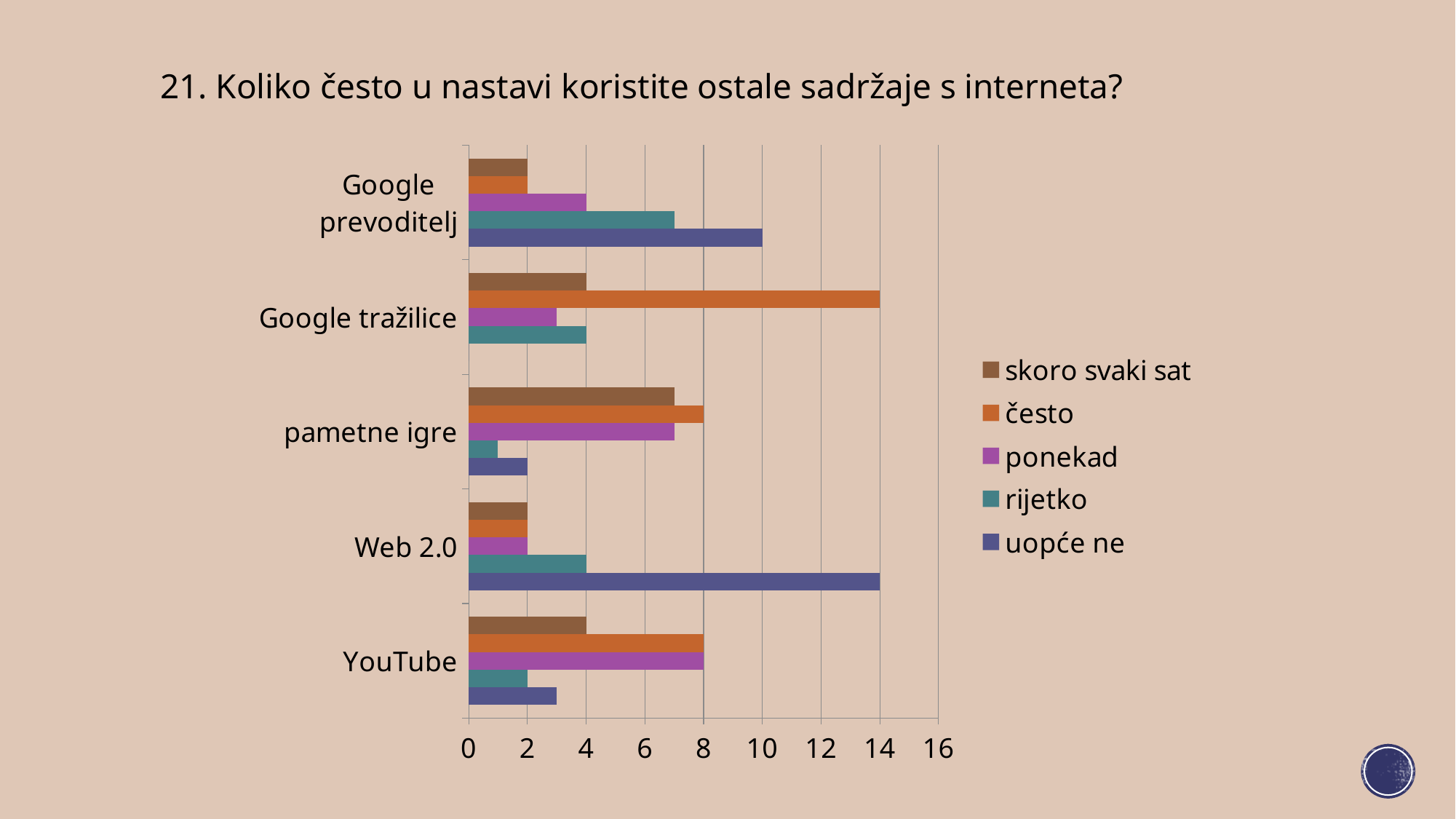
How many categories are shown on the chart? 5 What is the value for "uopće ne" for Google prevoditelj? 10 What is the value for "uopće ne" for Web 2.0? 14 How many series does the legend list? 5 Is the value for "rijetko" for Google prevoditelj greater or less than 6? greater Which is larger for pametne igre: "često" or "rijetko"? često Which category has the highest value for "često"? Google tražilice What is the difference between the "uopće ne" value for Web 2.0 and the "uopće ne" value for Google prevoditelj? 4 What is the value for "često" for YouTube? 8 What is the value for "često" for Google tražilice? 14 What kind of chart is shown on the slide? bar chart Which category has the lowest value for "uopće ne"? Google tražilice